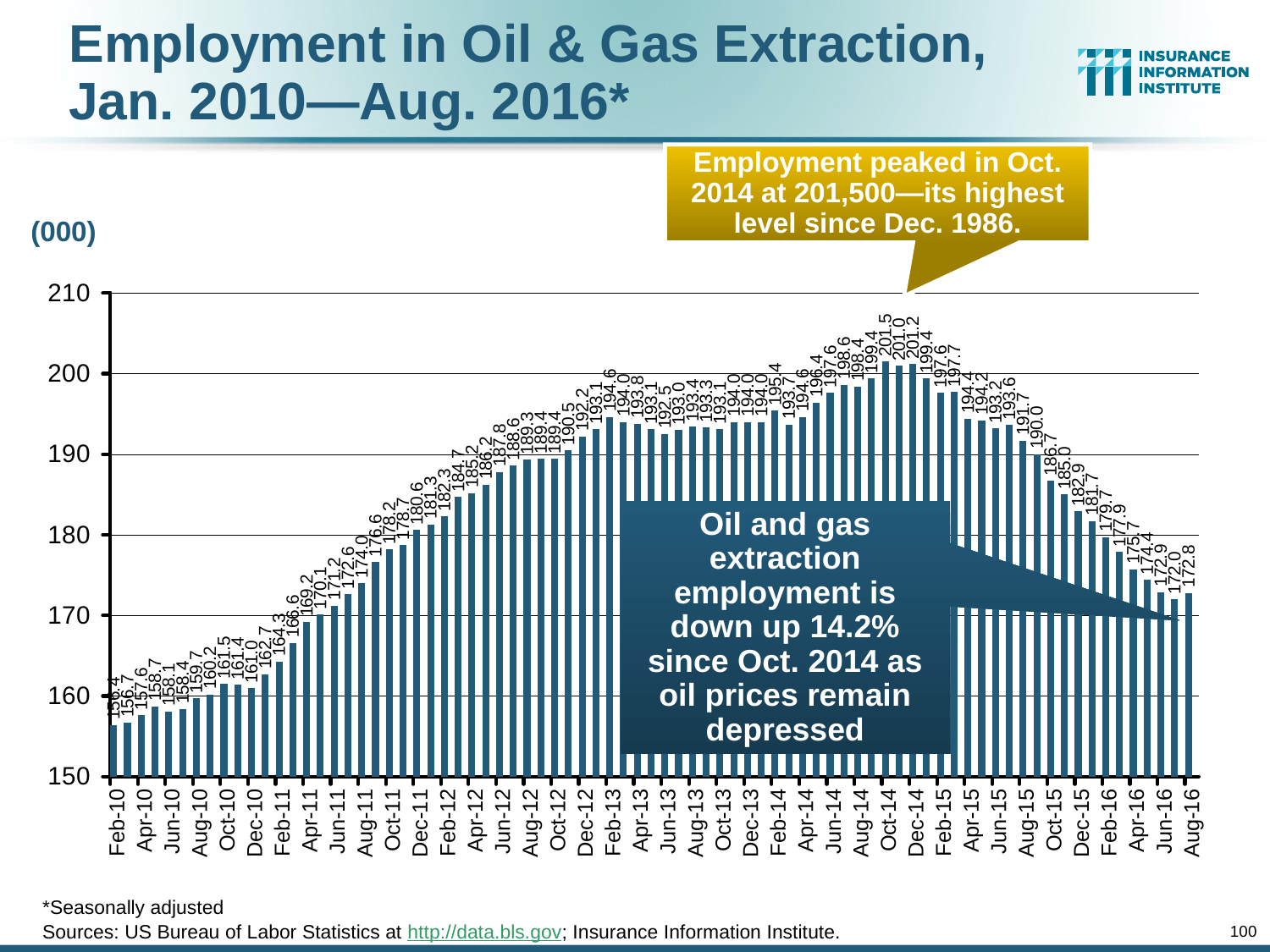
What unit is indicated for the y-axis values? (000) Is the value for Oct-14 greater or less than 200? greater Which is larger, the employment value for Oct-14 or for Aug-16? Oct-14 What type of chart is shown on the slide? Bar chart What is the highest employment value shown on the chart? 201.5 According to the callout, by what percentage is oil and gas extraction employment down since Oct. 2014? 14.2% Do the values rise or fall from Oct-14 to Aug-16? fall What is the lowest employment value labeled on the chart? 156.4 What is the employment value for Aug-16, the last bar on the chart? 172.8 What is the difference between the peak value (201.5) and the Aug-16 value (172.8)? 28.7 Is the value for Aug-16 greater or less than 180? less In which month did employment in oil & gas extraction peak? Oct-14